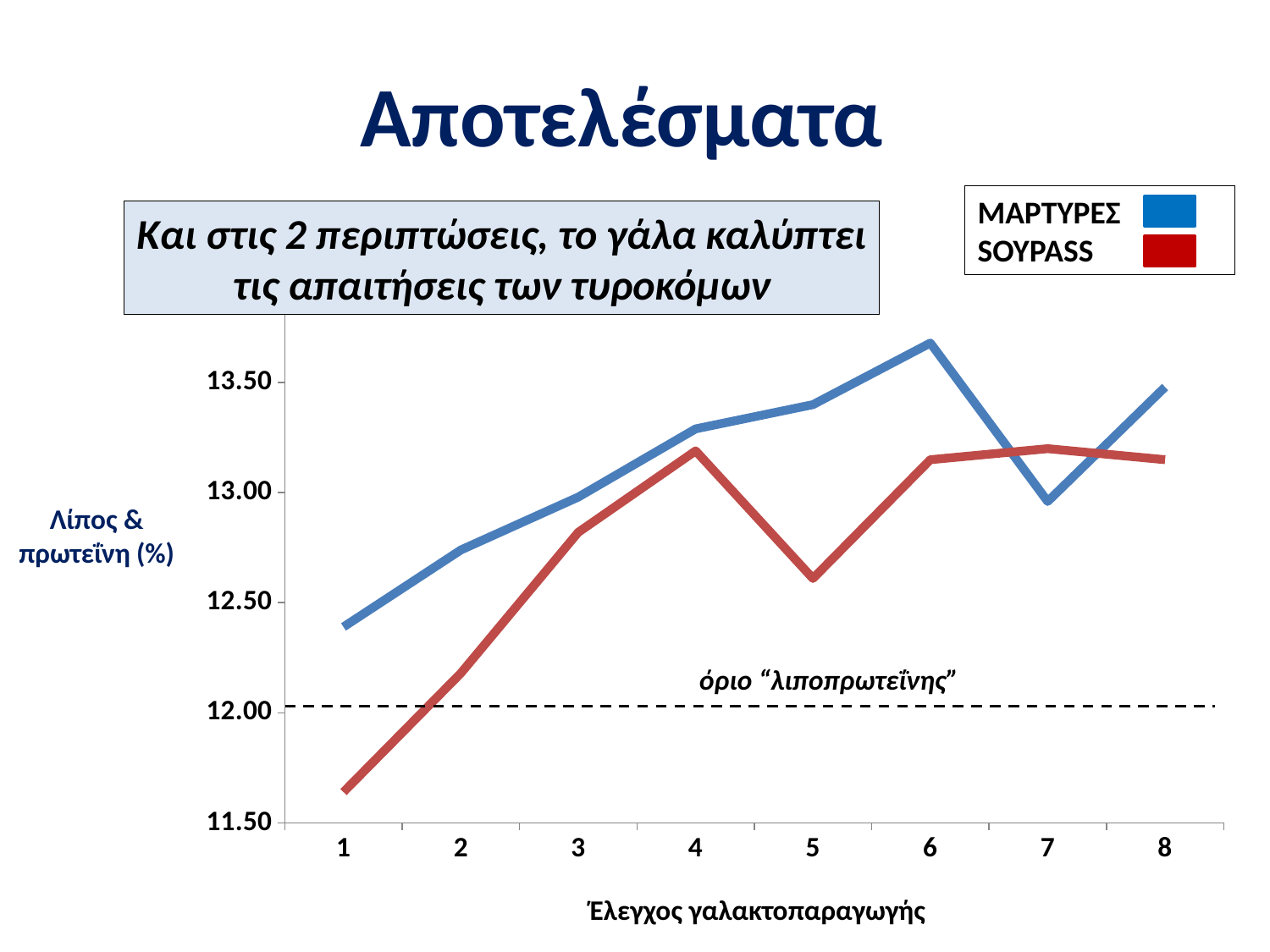
Is the SOYPASS value at check 5 greater or less than 12.50? greater At check 7, which series has the higher value, ΜΑΡΤΥΡΕΣ or SOYPASS? SOYPASS Is the SOYPASS value at check 1 greater or less than 12.00? less At which check does the SOYPASS series have its lowest value? 1 What colour is used for the SOYPASS series? Red What kind of chart is shown on the slide? Line chart At check 1, which series has the higher value, ΜΑΡΤΥΡΕΣ or SOYPASS? ΜΑΡΤΥΡΕΣ Does the ΜΑΡΤΥΡΕΣ series rise or fall from check 1 to check 6? rise How many milk-production checks (x-axis points) are plotted? 8 Is the ΜΑΡΤΥΡΕΣ value at check 6 greater or less than 13.50? greater How many series does the legend list? 2 At which check does the ΜΑΡΤΥΡΕΣ series reach its highest value? 6